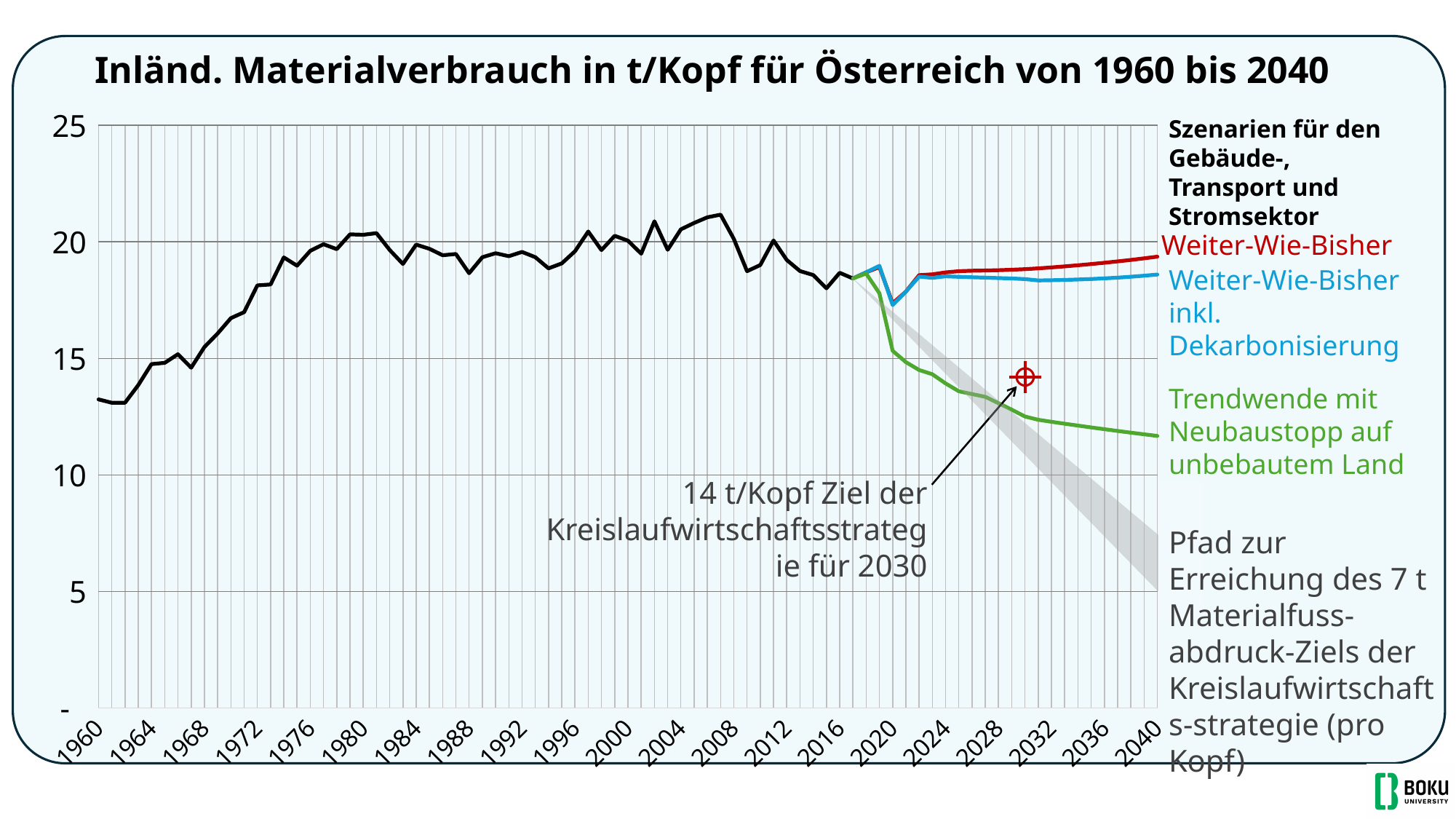
What kind of chart is shown on the slide? line chart Is the value of the green 'Trendwende mit Neubaustopp auf unbebautem Land' line in 2040 greater or less than 15? less Which colour is used for the 'Weiter-Wie-Bisher inkl. Dekarbonisierung' scenario line? blue Does the green 'Trendwende mit Neubaustopp auf unbebautem Land' line rise or fall between 2020 and 2040? fall What target value for 2030 is marked by the annotation on the chart? 14 t/Kopf Is the value of the black historical line in 1960 greater or less than 15? less Does the black historical line rise or fall between 1960 and 1980? rise In 2040, which line is higher: the red 'Weiter-Wie-Bisher' line or the green 'Trendwende mit Neubaustopp auf unbebautem Land' line? Weiter-Wie-Bisher Is the value of the red 'Weiter-Wie-Bisher' line in 2040 greater or less than 20? less What is the title of the chart? Inländ. Materialverbrauch in t/Kopf für Österreich von 1960 bis 2040 How many coloured scenario lines (red, blue, green) are plotted after the historical black line? 3